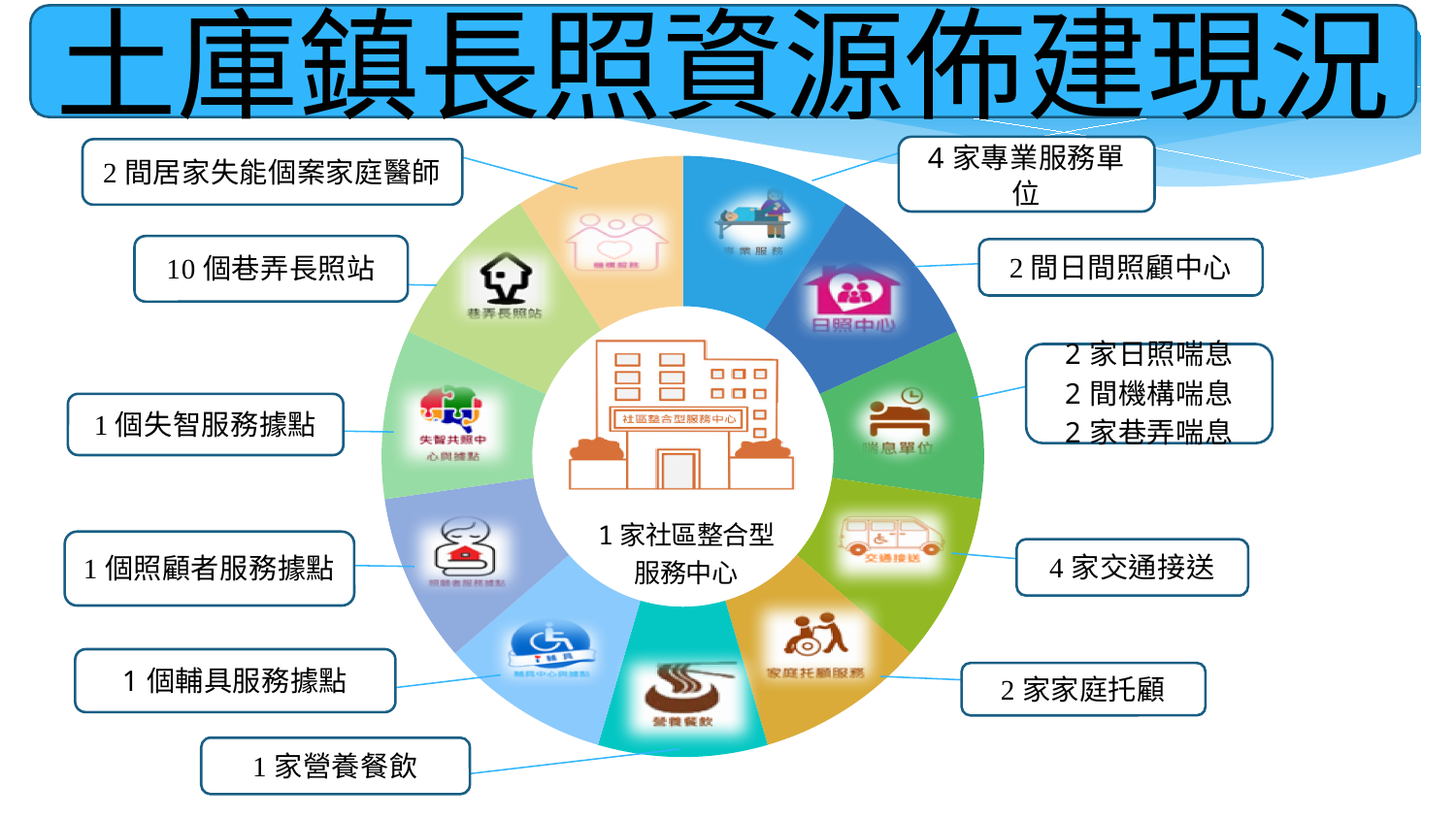
How many 交通接送 providers are listed on the slide? 4 家 How many 家庭托顧 providers are listed on the slide? 2 家 How many 專業服務單位 are listed on the slide? 4 家 How many 居家失能個案家庭醫師 are listed on the slide? 2 間 Which is larger, the number of 專業服務單位 or the number of 家庭托顧? 專業服務單位 How many 日間照顧中心 are listed on the slide? 2 間 Which resource category has the largest number listed on the slide? 巷弄長照站 (10 個) What kind of diagram is shown on the slide? A ring (donut) diagram How many 營養餐飲 providers are listed on the slide? 1 家 What is written in the centre of the ring diagram? 1 家社區整合型服務中心 How many 巷弄長照站 are listed on the slide? 10 個 What is the difference between the number of 巷弄長照站 and the number of 交通接送 providers? 6